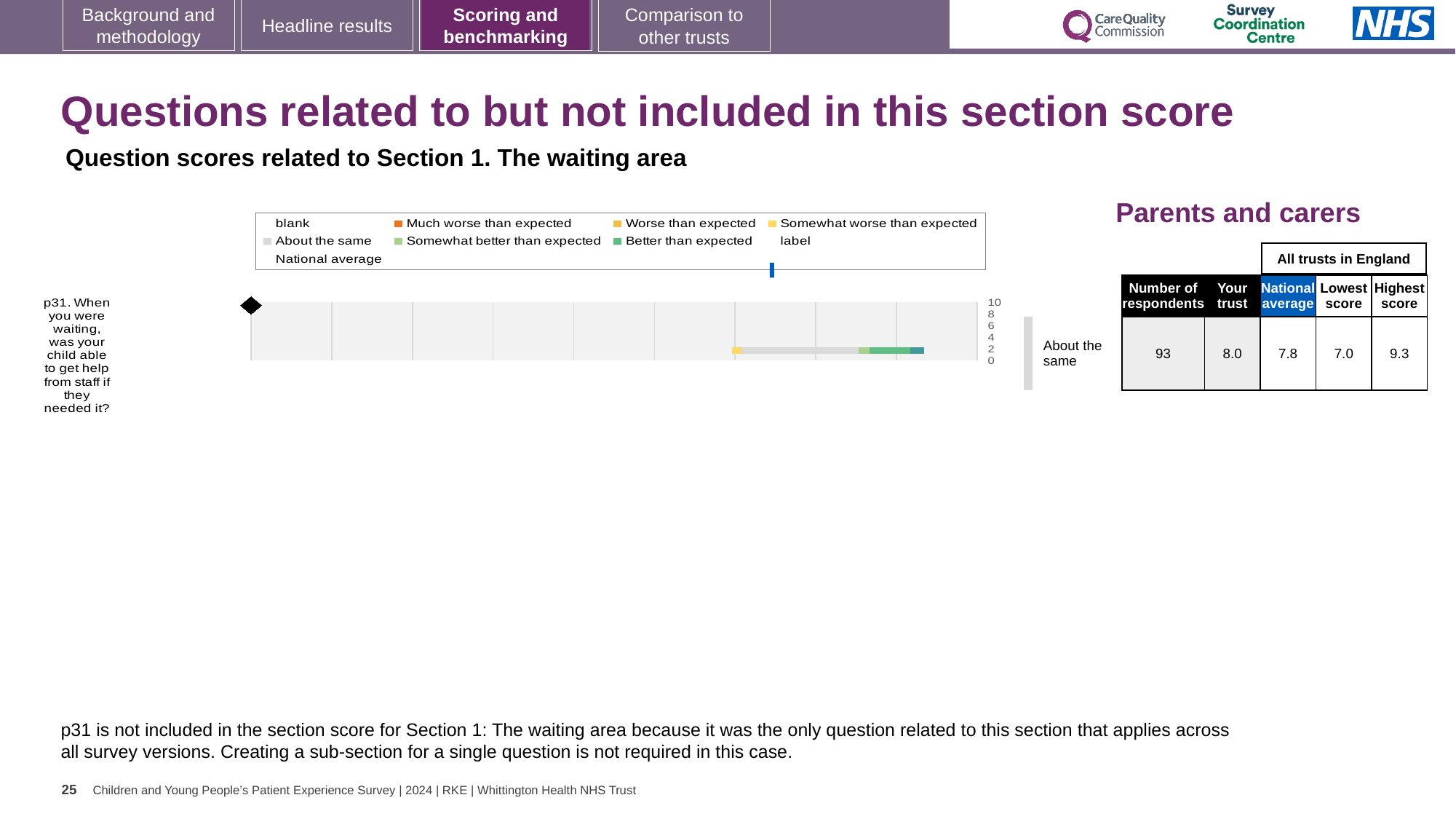
Which survey question is plotted in the chart? p31. When you were waiting, was your child able to get help from staff if they needed it? What is the difference between the 'Your trust' score and the national average for p31? 0.2 In the table next to the chart, what is the highest score among all trusts in England for p31? 9.3 What category label is shown to the right of the bar for p31? About the same In the table next to the chart, what is the 'Your trust' score for p31? 8.0 How many survey questions are plotted in the chart? 1 What is the difference between the highest score and the lowest score for p31? 2.3 How many respondents answered p31? 93 In the table next to the chart, what is the lowest score among all trusts in England for p31? 7.0 What kind of chart is shown on the slide? bar chart Which is larger for p31, the 'Your trust' score or the national average? Your trust In the table next to the chart, what is the national average score for p31? 7.8